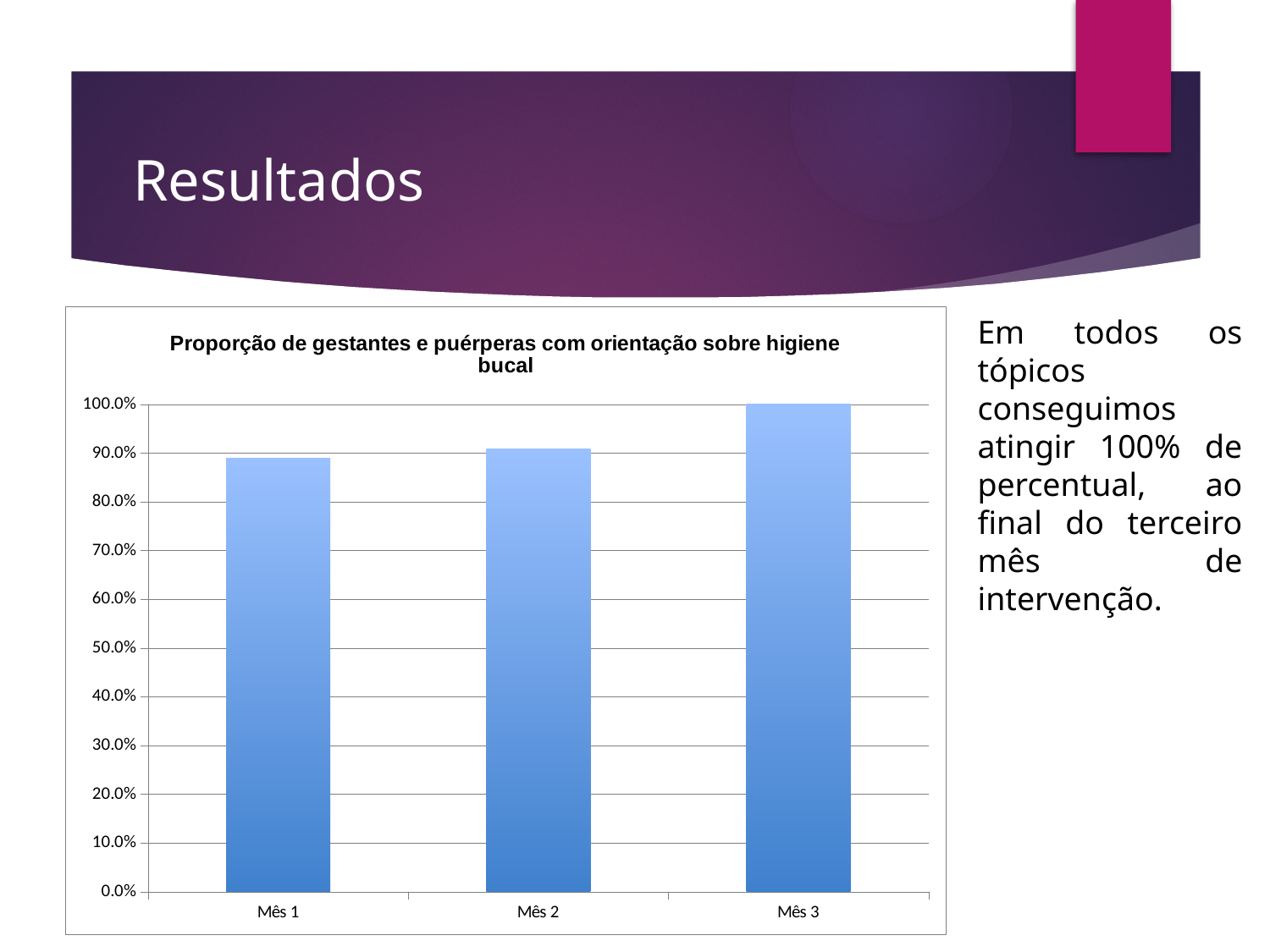
What type of chart is shown on the slide? Bar chart Which is larger, the value for Mês 3 or the value for Mês 1? Mês 3 Is the value for Mês 2 greater or less than 80.0%? greater Which month has the highest value? Mês 3 Do the values rise or fall from Mês 1 to Mês 3? Rise What is the label of the last category on the x axis? Mês 3 What is the value for Mês 3? 100.0% What is the title of the chart? Proporção de gestantes e puérperas com orientação sobre higiene bucal Is the value for Mês 1 greater or less than 80.0%? greater How many categories are shown on the x axis of the chart? 3 Which month has the lowest value? Mês 1 Is the value for Mês 2 greater or less than 100.0%? less